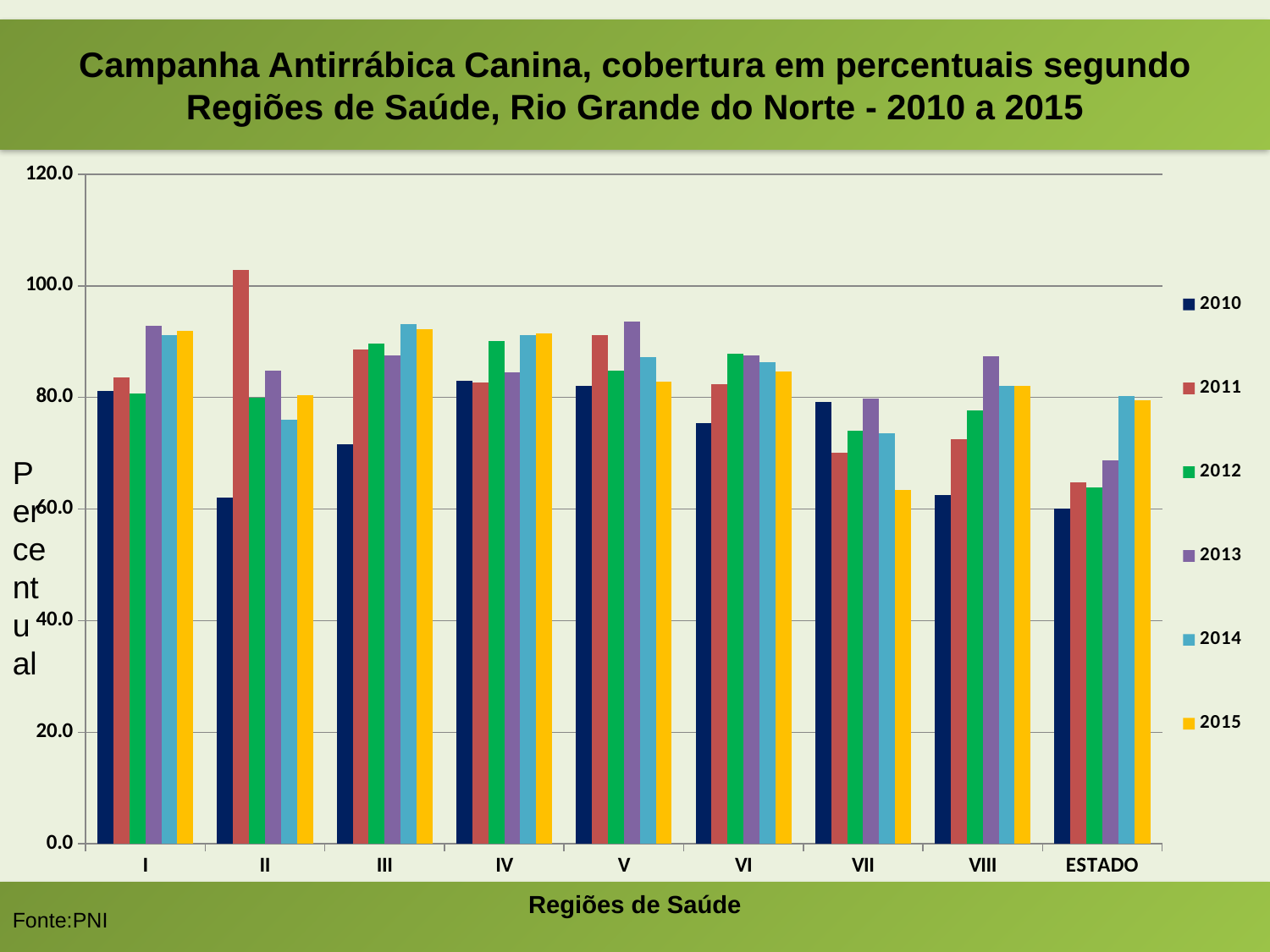
Which is larger: the 2010 value for region IV or the 2010 value for region VI? region IV How many categories are shown on the x axis? 9 Is the 2014 value for region VII greater or less than 80? less Which category has the lowest 2015 value? VII How many series does the legend list? 6 Is the 2013 value for region V greater or less than 80? greater Is the 2010 value for region VIII greater or less than 80? less What is the title of the x axis? Regiões de Saúde What kind of chart is shown on the slide? bar chart In region II, which is larger: the 2010 value or the 2011 value? 2011 Which region has the highest 2011 value? II